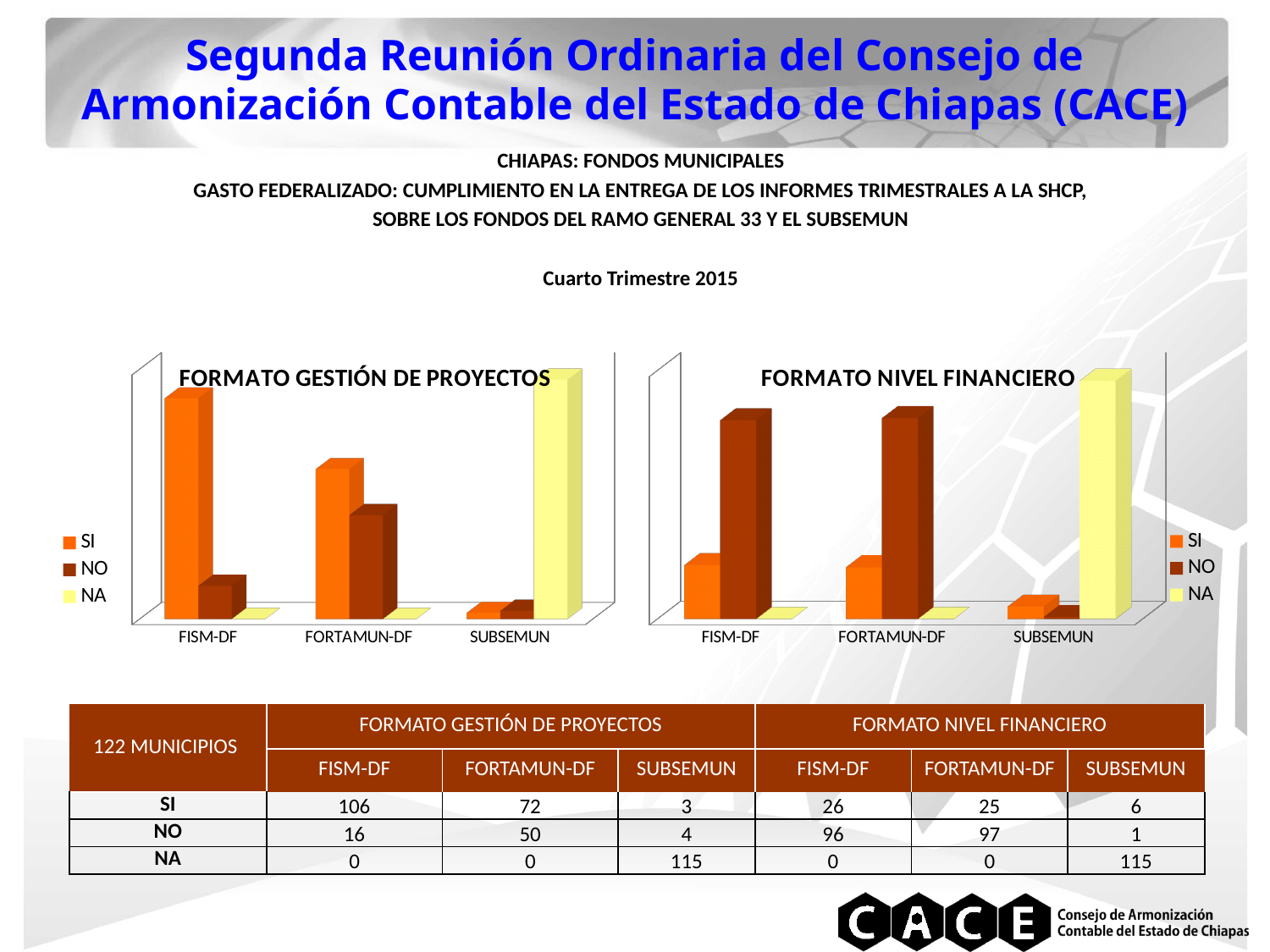
How many categories are shown on the x axis of the FORMATO GESTIÓN DE PROYECTOS chart? 3 In the FORMATO NIVEL FINANCIERO chart, is the SI value or the NO value larger for FISM-DF? NO In the FORMATO GESTIÓN DE PROYECTOS chart, what is the SI value for FISM-DF? 106 How many series does the legend of the FORMATO NIVEL FINANCIERO chart list? 3 In the FORMATO GESTIÓN DE PROYECTOS chart, what is the difference between the SI and NO values for FORTAMUN-DF? 22 Which series is shown in yellow in the legend of the FORMATO GESTIÓN DE PROYECTOS chart? NA In the FORMATO NIVEL FINANCIERO chart, what is the NA value for SUBSEMUN? 115 In the FORMATO NIVEL FINANCIERO chart, what is the NO value for FORTAMUN-DF? 97 In the FORMATO GESTIÓN DE PROYECTOS chart, which category has the highest NA value? SUBSEMUN In the FORMATO GESTIÓN DE PROYECTOS chart, is the SI value or the NO value larger for FISM-DF? SI What type of chart is the FORMATO GESTIÓN DE PROYECTOS chart? bar chart In the FORMATO NIVEL FINANCIERO chart, which category has the lowest NO value? SUBSEMUN